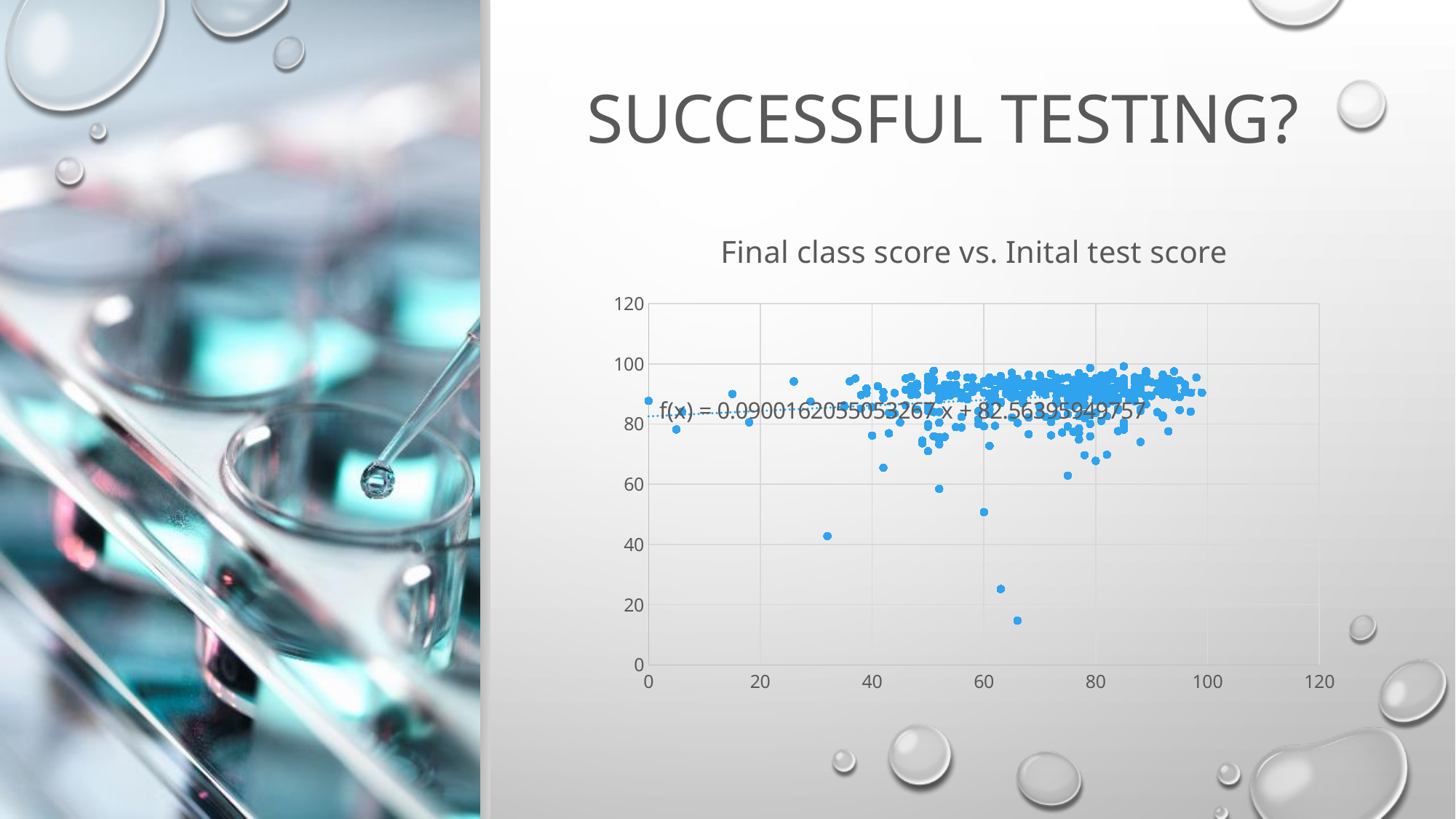
Between which two vertical-axis gridlines do most of the plotted points fall? 80 and 100 Does the dotted trendline rise or fall as the x value increases? rise What kind of chart is shown on the slide? Scatter chart What is the highest tick label shown on the horizontal axis? 120 Is the y value of the lowest plotted point (near x = 66) greater or less than 20? less Is the y value of the point near x = 60 that sits below the main cluster greater or less than 60? less What is the title of the chart? Final class score vs. Inital test score Is the intercept of the trendline (its value at x = 0) greater or less than 80? greater What is the highest value shown on the vertical axis of the chart? 120 What is the spacing between consecutive tick labels on the vertical axis? 20